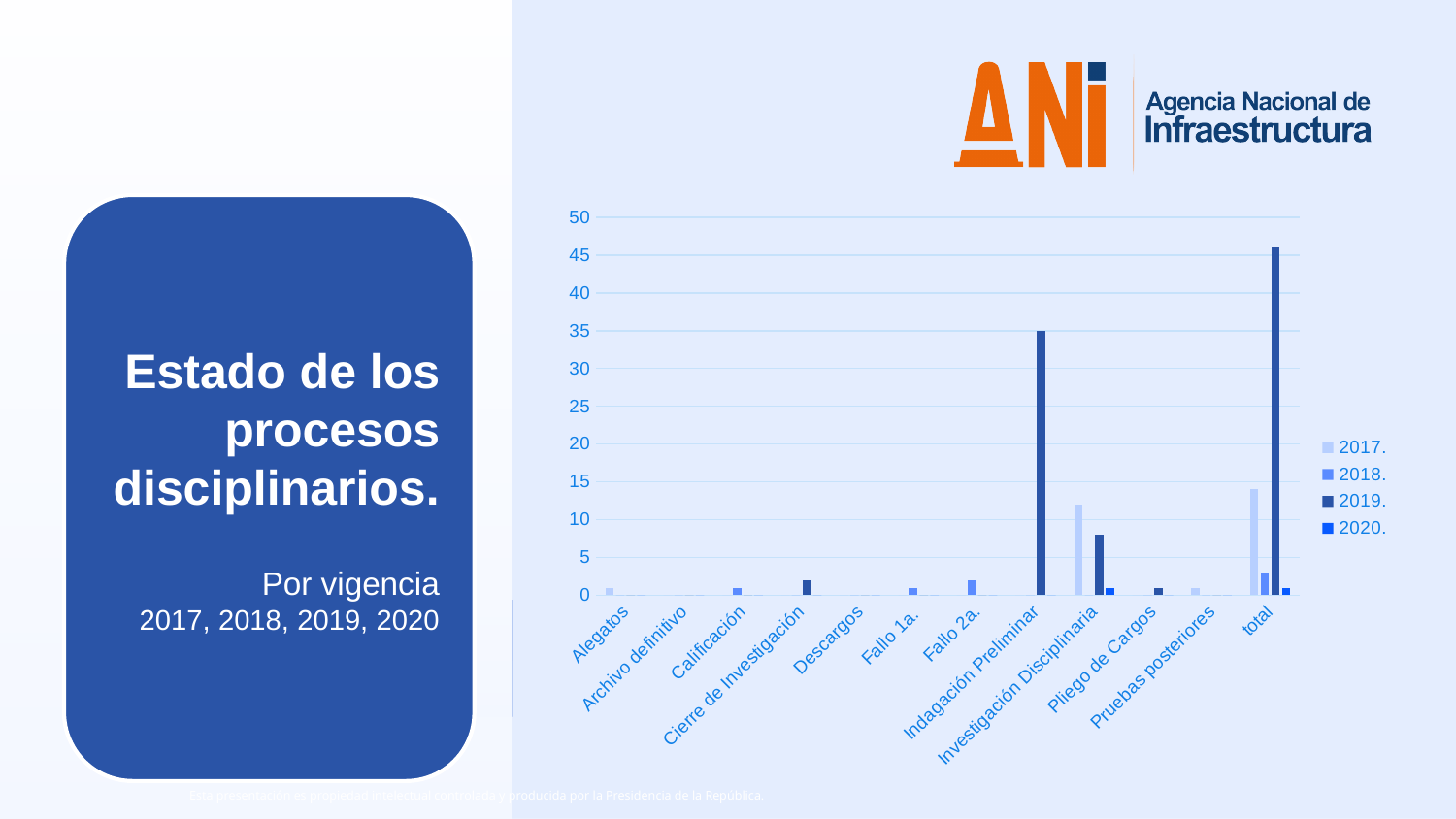
Is the 2019 value for Investigación Disciplinaria greater or less than 10? less Is the 2017 value for Investigación Disciplinaria greater or less than 10? greater Which years are listed in the chart legend? 2017, 2018, 2019, 2020 Is the 2019 value for total greater or less than 40? greater Which is larger for 2019: Indagación Preliminar or Investigación Disciplinaria? Indagación Preliminar How many categories are shown on the x axis of the chart? 12 How many series does the legend list? 4 What kind of chart is shown on the slide? bar chart For Investigación Disciplinaria, which year has the larger value: 2017 or 2019? 2017 Excluding the total category, which category has the tallest 2019 bar? Indagación Preliminar Which category has the tallest 2019 bar? total